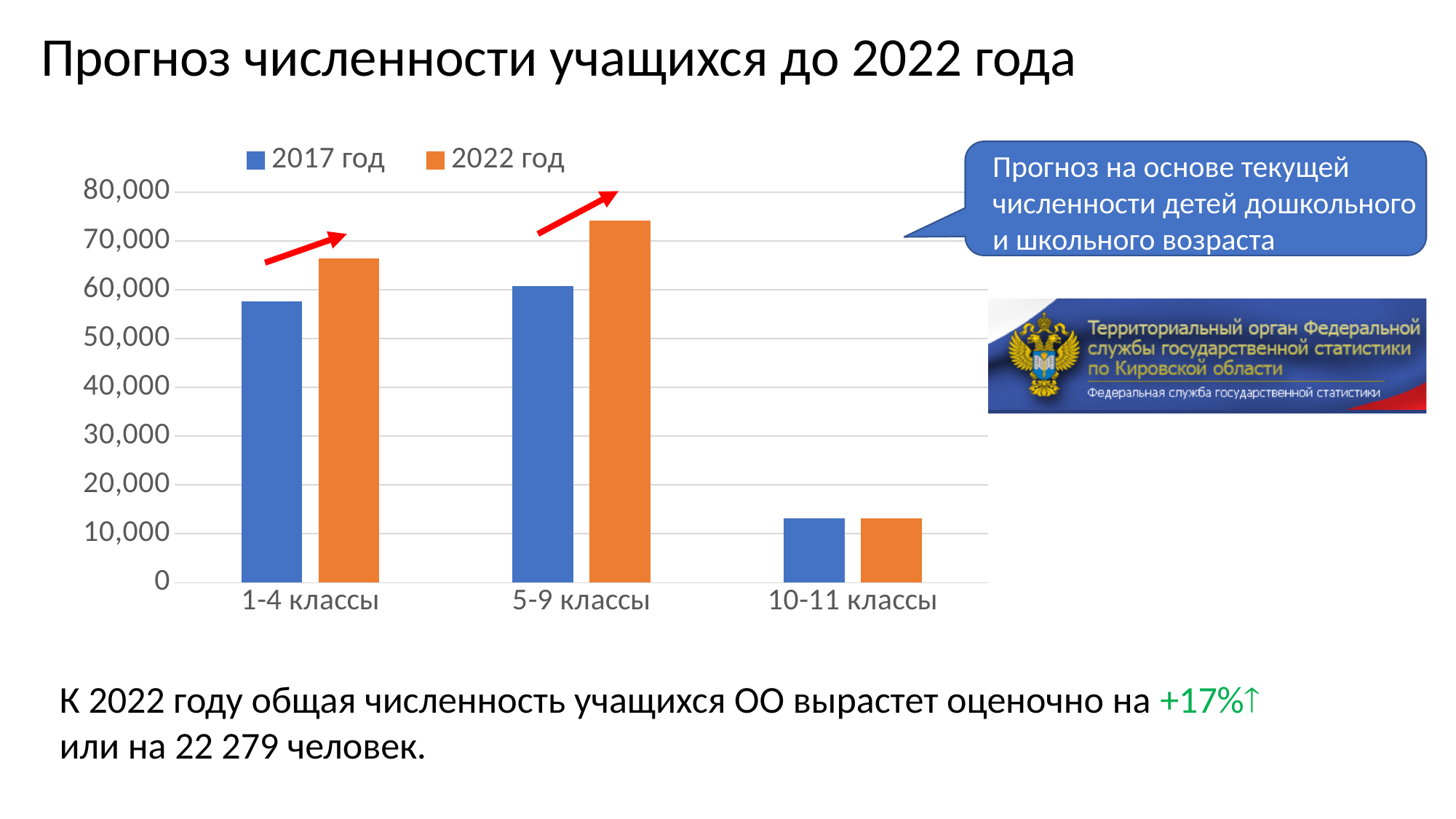
For 1-4 классы, which series has the larger value, 2017 год or 2022 год? 2022 год What kind of chart is shown on the slide? bar chart Is the 2022 год value for 1-4 классы greater or less than 70,000? less Which category has the highest value for the 2022 год series? 5-9 классы For 5-9 классы, which series has the larger value, 2017 год or 2022 год? 2022 год How many categories are shown on the x axis of the chart? 3 Which category has the lowest value for the 2017 год series? 10-11 классы Is the 2022 год value for 5-9 классы greater or less than 70,000? greater What are the two entries in the chart legend? 2017 год and 2022 год Is the 2017 год value for 10-11 классы greater or less than 20,000? less How many series does the chart legend list? 2